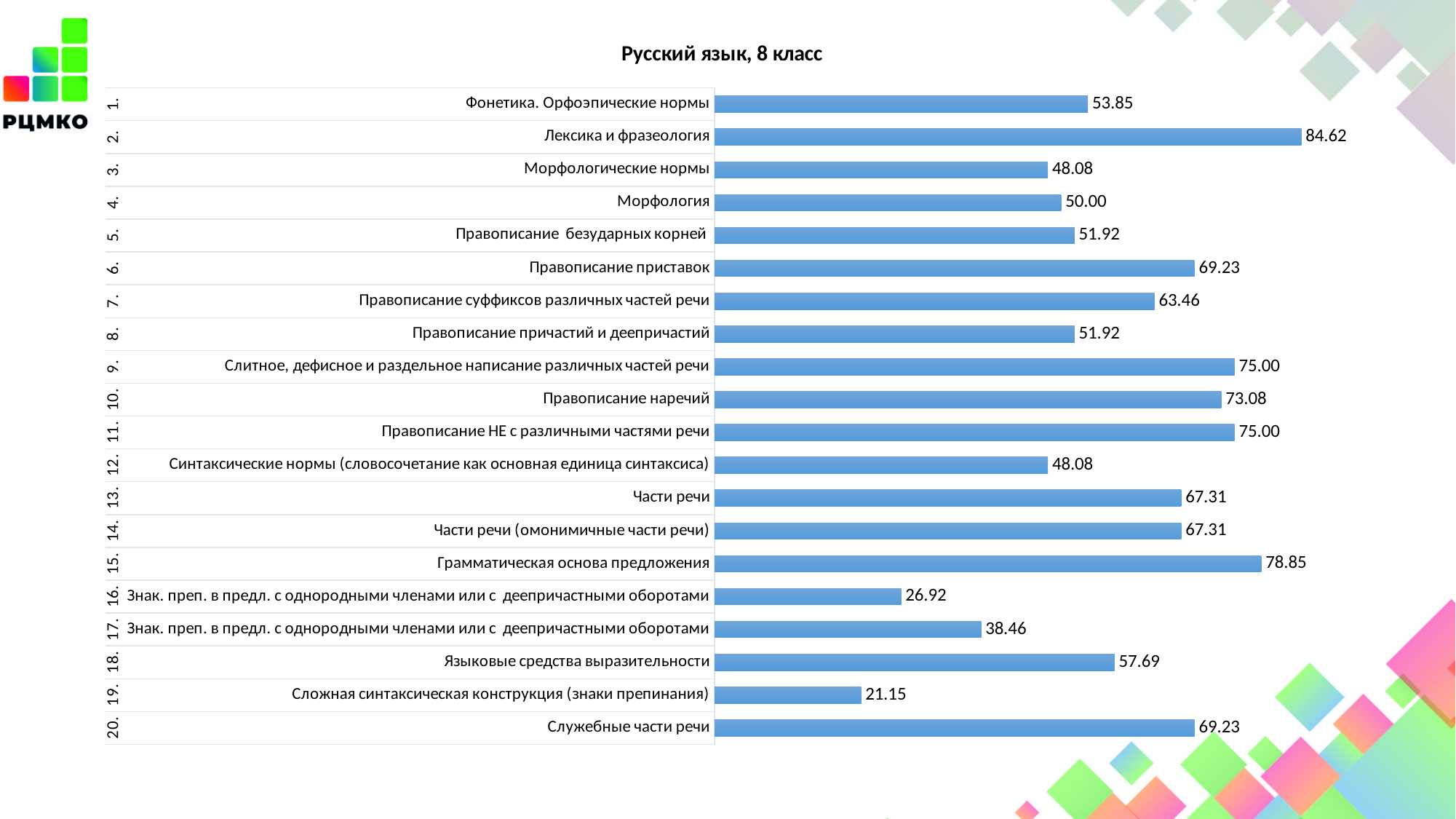
Which category has the lowest value? Сложная синтаксическая конструкция (знаки препинания) What is the value for Лексика и фразеология? 84.62 How many categories are shown in the chart? 20 What is the title of the chart? Русский язык, 8 класс Which category has the highest value? Лексика и фразеология What is the value for item 17 in the chart? 38.46 What kind of chart is shown on the slide? Bar chart What is the difference between the values for Правописание приставок and Правописание суффиксов различных частей речи? 5.77 Which is larger, the value for Правописание наречий or the value for Языковые средства выразительности? Правописание наречий What is the value for Грамматическая основа предложения? 78.85 What is the difference between the values for Лексика и фразеология and Морфология? 34.62 What is the value for Сложная синтаксическая конструкция (знаки препинания)? 21.15